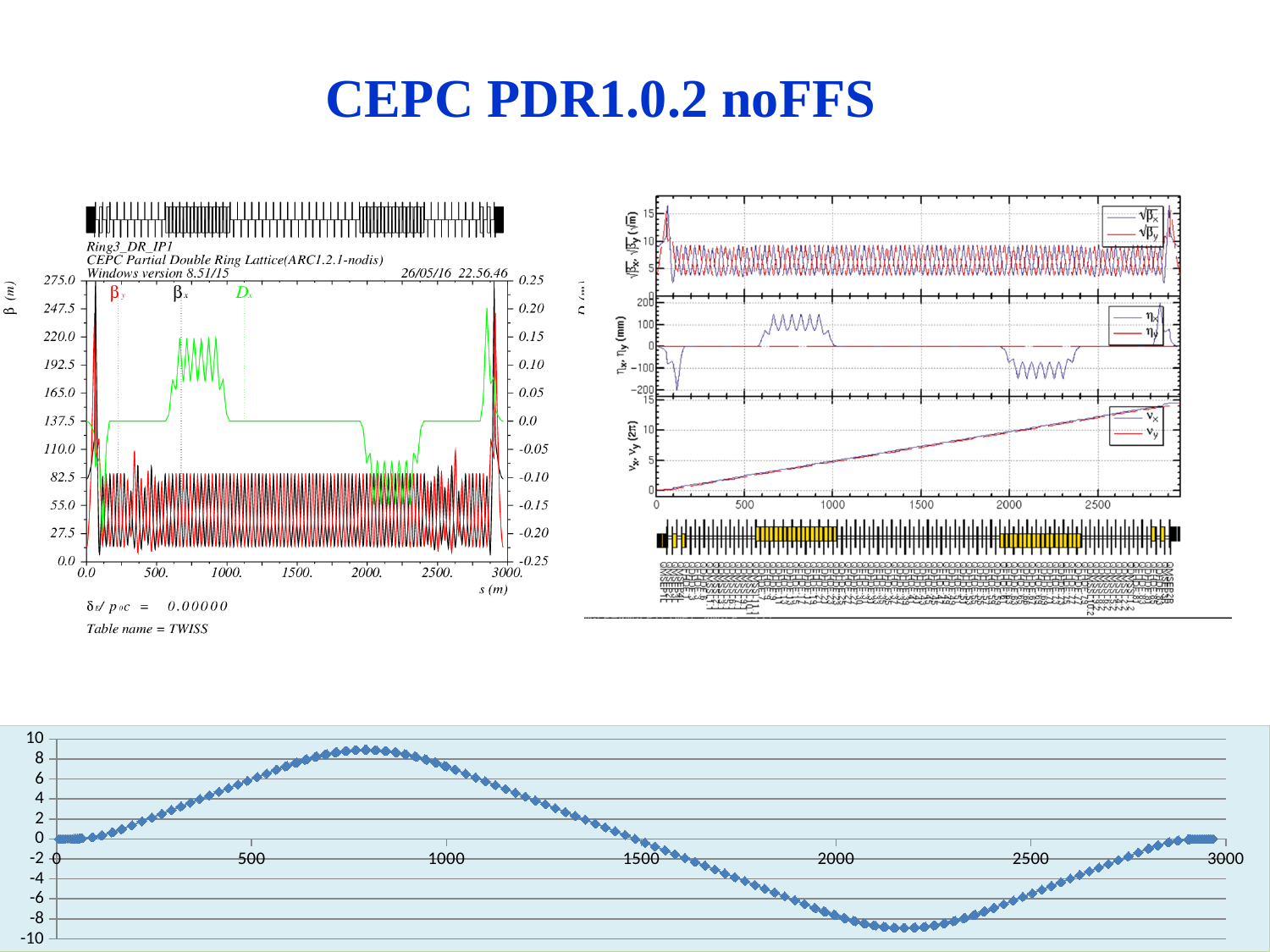
In the bottom chart, do the values rise or fall between x = 1000 and x = 2000? fall In the top-left chart, what is the maximum value on the left β (m) axis? 275.0 In the top-left chart, is the value of Dx at s = 800 greater or less than 0.10? greater In the top-left chart, is the value of Dx at s = 2200 greater or less than 0.0? less In the bottom chart, what is the highest value shown on the y axis? 10 In the bottom chart, is the value at x = 500 greater or less than 4? greater In the bottom chart, what is the largest value shown on the x axis? 3000 What kind of chart is the bottom chart on the slide? scatter chart How many series does the legend of the middle panel of the top-right chart list? 2 In the bottom panel of the top-right chart, do the values of νx rise or fall as s increases from 0 to 2500? rise